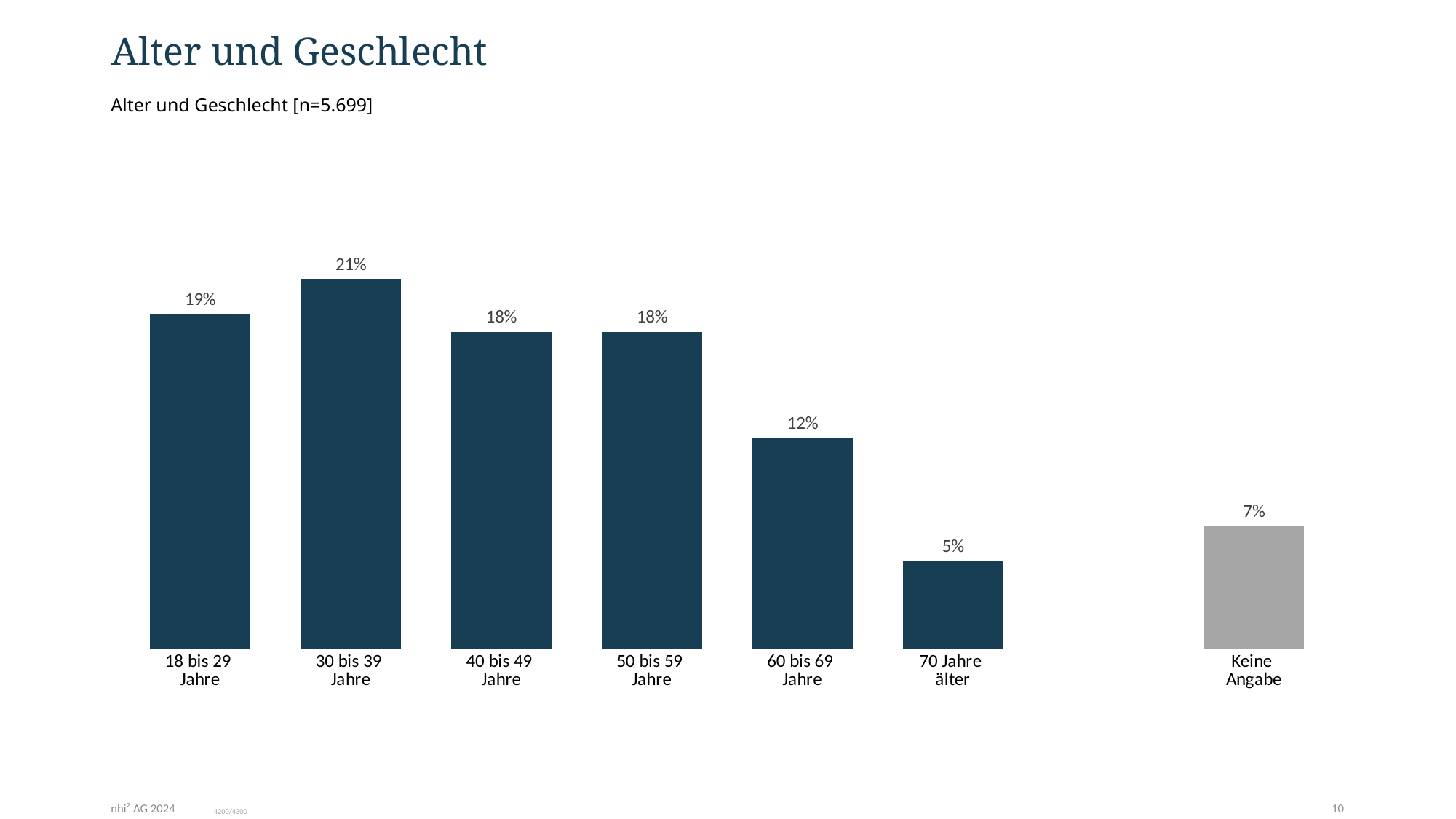
Which is larger, the value for 60 bis 69 Jahre or the value for Keine Angabe? 60 bis 69 Jahre What is the difference between the values for 18 bis 29 Jahre and 60 bis 69 Jahre? 7% What is the difference between the values for 30 bis 39 Jahre and 70 Jahre älter? 16% What is the value for 30 bis 39 Jahre? 21% What kind of chart is shown on the slide? Bar chart What is the title of the chart? Alter und Geschlecht [n=5.699] How many categories are shown in the chart? 7 What is the value for 18 bis 29 Jahre? 19% Which category has the lowest value? 70 Jahre älter What is the value for Keine Angabe? 7% What is the value for 60 bis 69 Jahre? 12% Which category has the highest value? 30 bis 39 Jahre